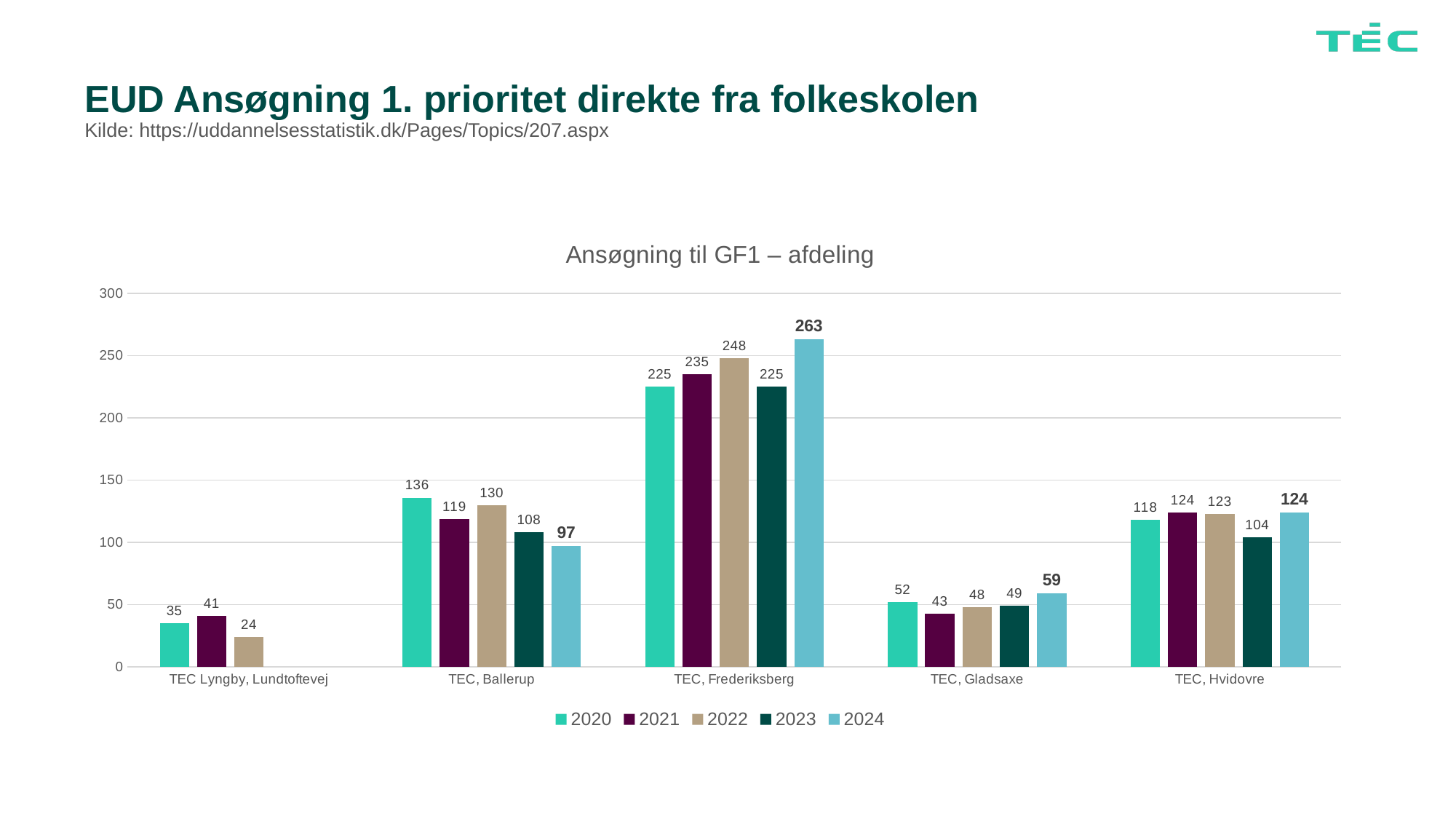
How many series does the legend list? 5 Is the value for TEC, Frederiksberg in 2022 greater or less than 200? greater What is the value for TEC, Ballerup in 2020? 136 What is the value for TEC, Frederiksberg in 2024? 263 What is the title of the chart? Ansøgning til GF1 – afdeling What is the difference between the 2024 and 2023 values for TEC, Ballerup? 11 What is the value for TEC Lyngby, Lundtoftevej in 2022? 24 Which is larger for TEC, Gladsaxe: the 2020 value or the 2024 value? 2024 What kind of chart is shown on the slide? Bar chart How many categories are shown on the x axis? 5 Which category has the highest value in 2023? TEC, Frederiksberg Which category has the lowest value in 2021? TEC Lyngby, Lundtoftevej